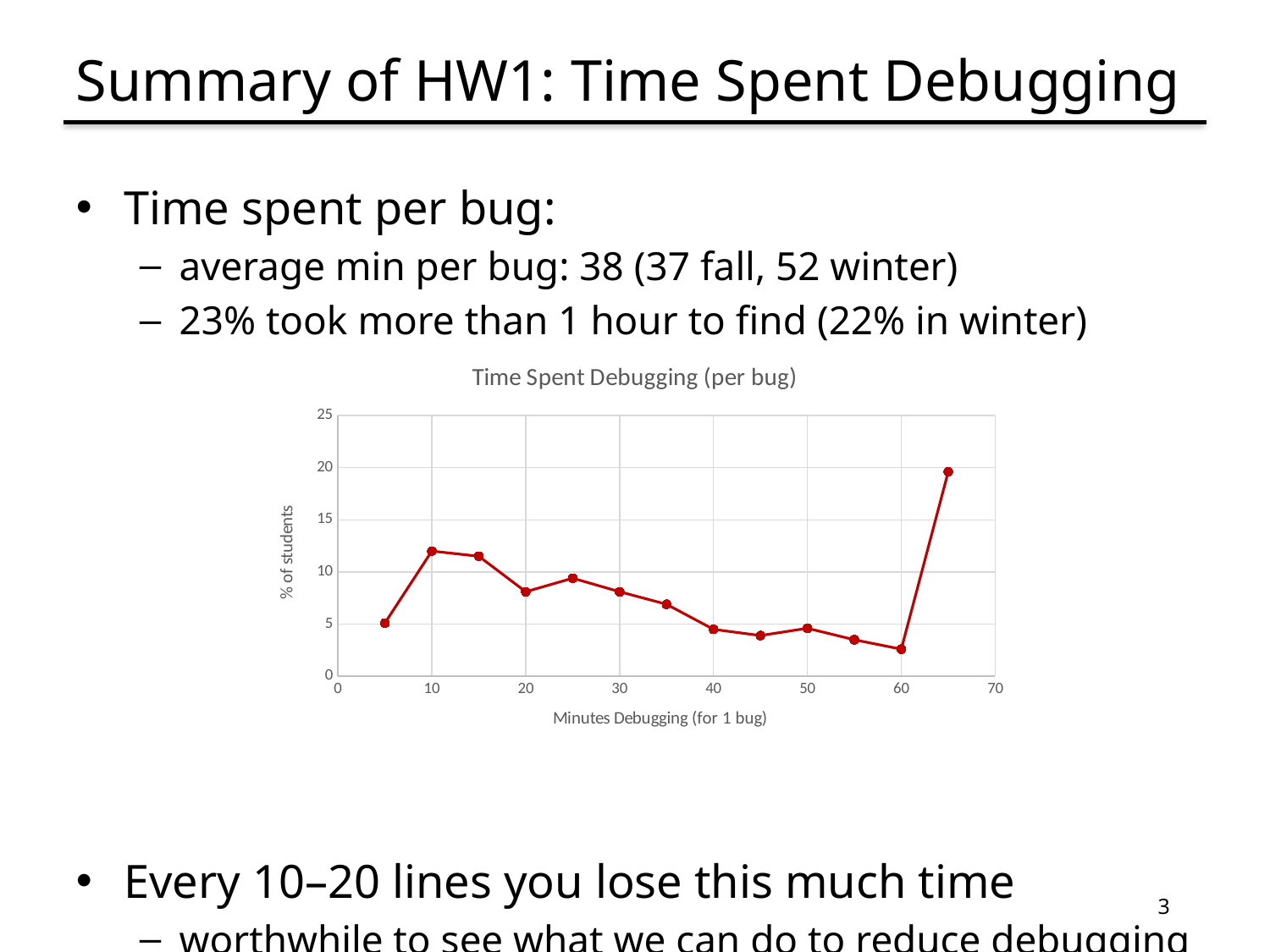
What is the label of the y axis of the chart? % of students Is the value for 65 minutes greater or less than 15? greater How many data points are plotted on the line? 13 Which has a higher % of students: 10 minutes or 60 minutes? 10 minutes What kind of chart is shown on the slide? line chart Is the value for 20 minutes greater or less than 10? less Is the value for 60 minutes greater or less than 5? less At which number of minutes debugging is the % of students highest? 65 Between 10 and 60 minutes debugging, do the values generally rise or fall? fall At which number of minutes debugging is the % of students lowest? 60 What is the title of the chart? Time Spent Debugging (per bug)